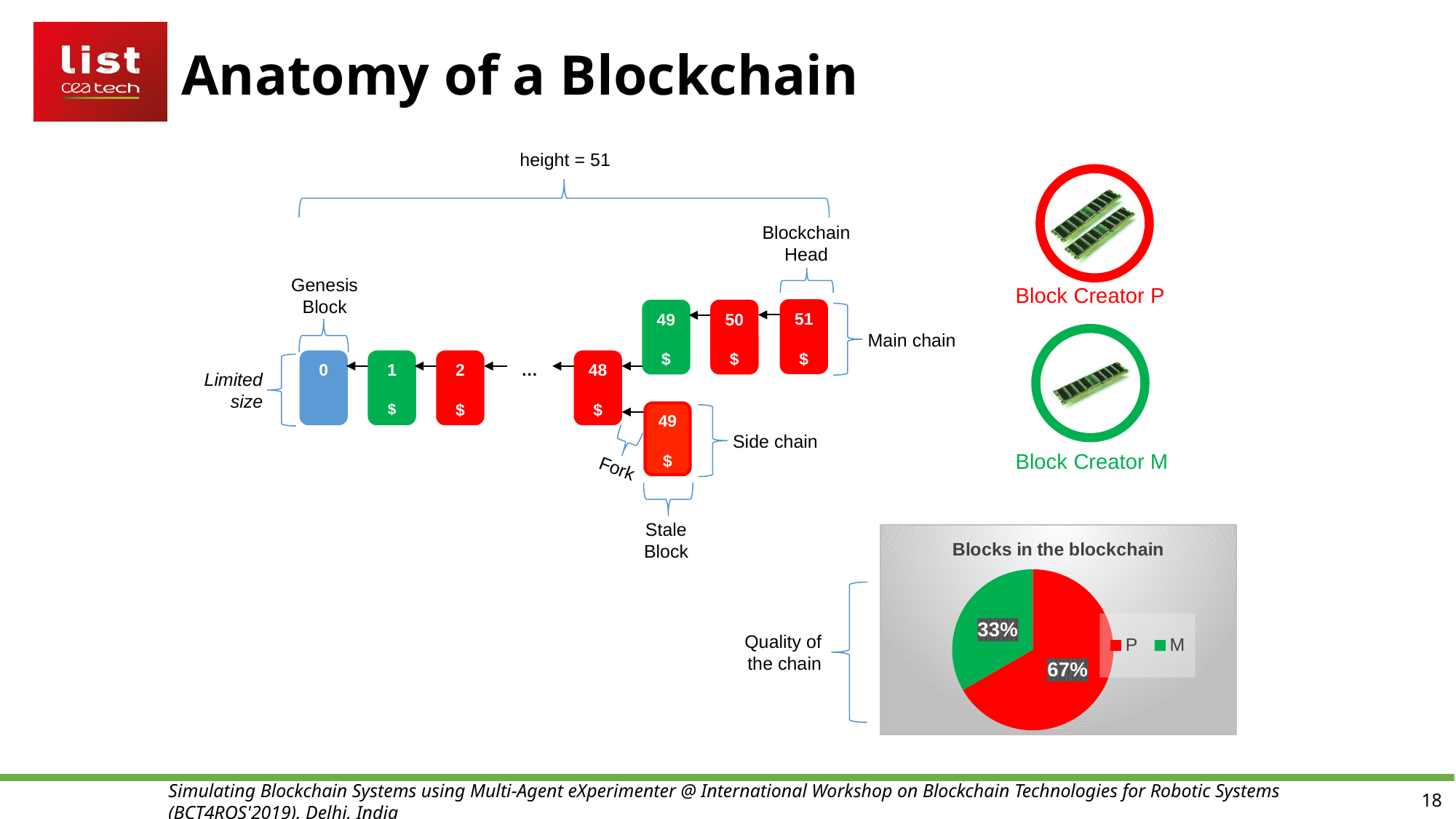
In the "Blocks in the blockchain" chart, what share of blocks is P? 67% How many entries does the legend of the "Blocks in the blockchain" chart list? 2 In the "Blocks in the blockchain" chart, what is the difference in percentage points between P and M? 34 In the "Blocks in the blockchain" chart, which slice is the smallest? M In the "Blocks in the blockchain" chart, which is larger, P or M? P What kind of chart is "Blocks in the blockchain"? pie chart In the "Blocks in the blockchain" chart, which slice is the largest? P What is the title of the pie chart on the slide? Blocks in the blockchain In the "Blocks in the blockchain" chart, what colour is the P slice? red In the "Blocks in the blockchain" chart, what share of blocks is M? 33% How many slices does the "Blocks in the blockchain" pie chart have? 2